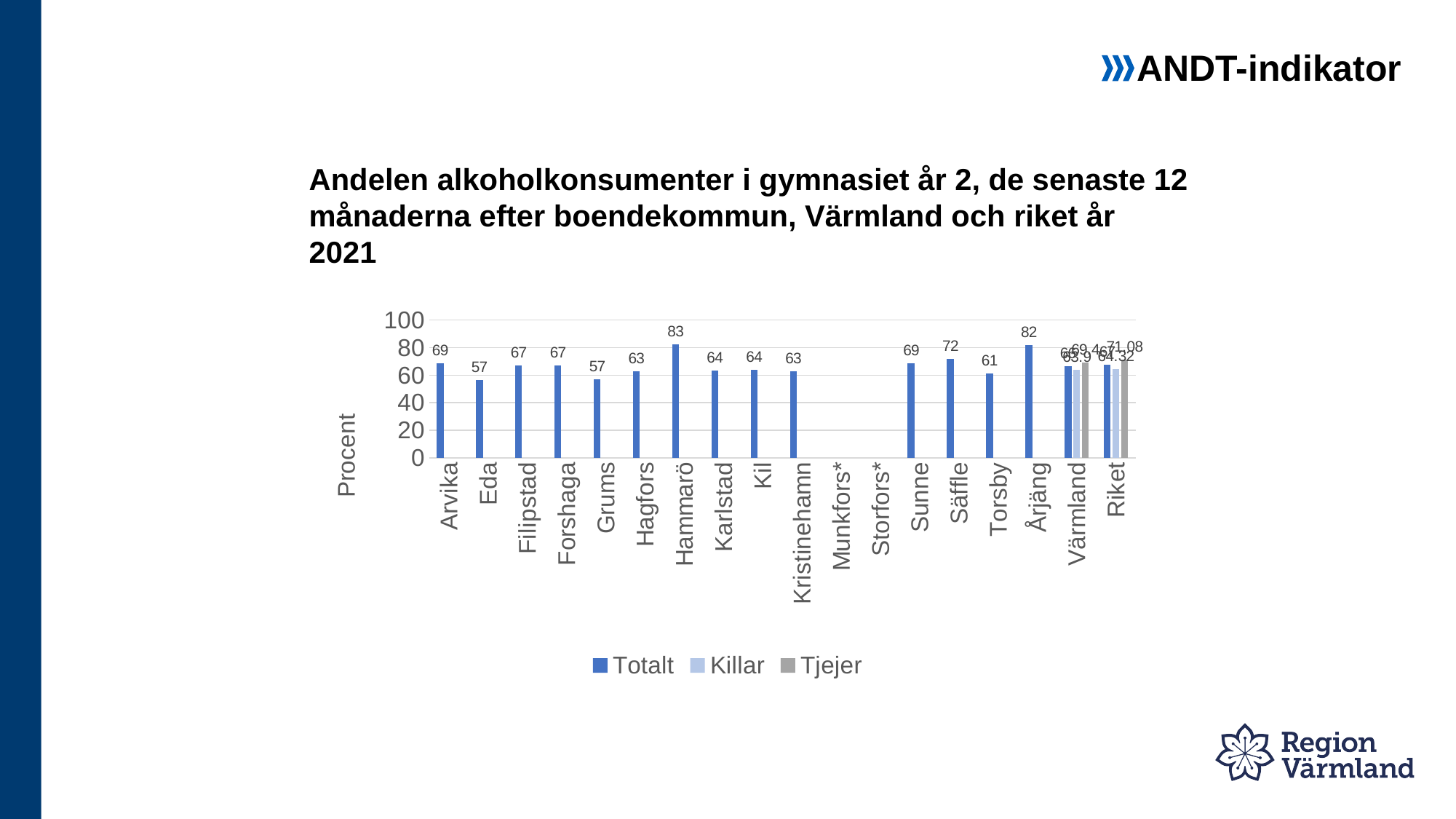
What is the Killar value for Värmland? 63.9 What is the difference between the Totalt values for Hammarö and Eda? 26 What is the Tjejer value for Riket? 71.08 What is the Totalt value for Hammarö? 83 What kind of chart is shown on the slide? Bar chart Is the Totalt value for Värmland greater or less than 60? greater What is the label on the y axis? Procent Which category has the highest Totalt value? Hammarö Which has the larger Totalt value, Säffle or Sunne? Säffle How many categories are shown on the x axis? 18 How many series does the legend list? 3 What is the Totalt value for Torsby? 61